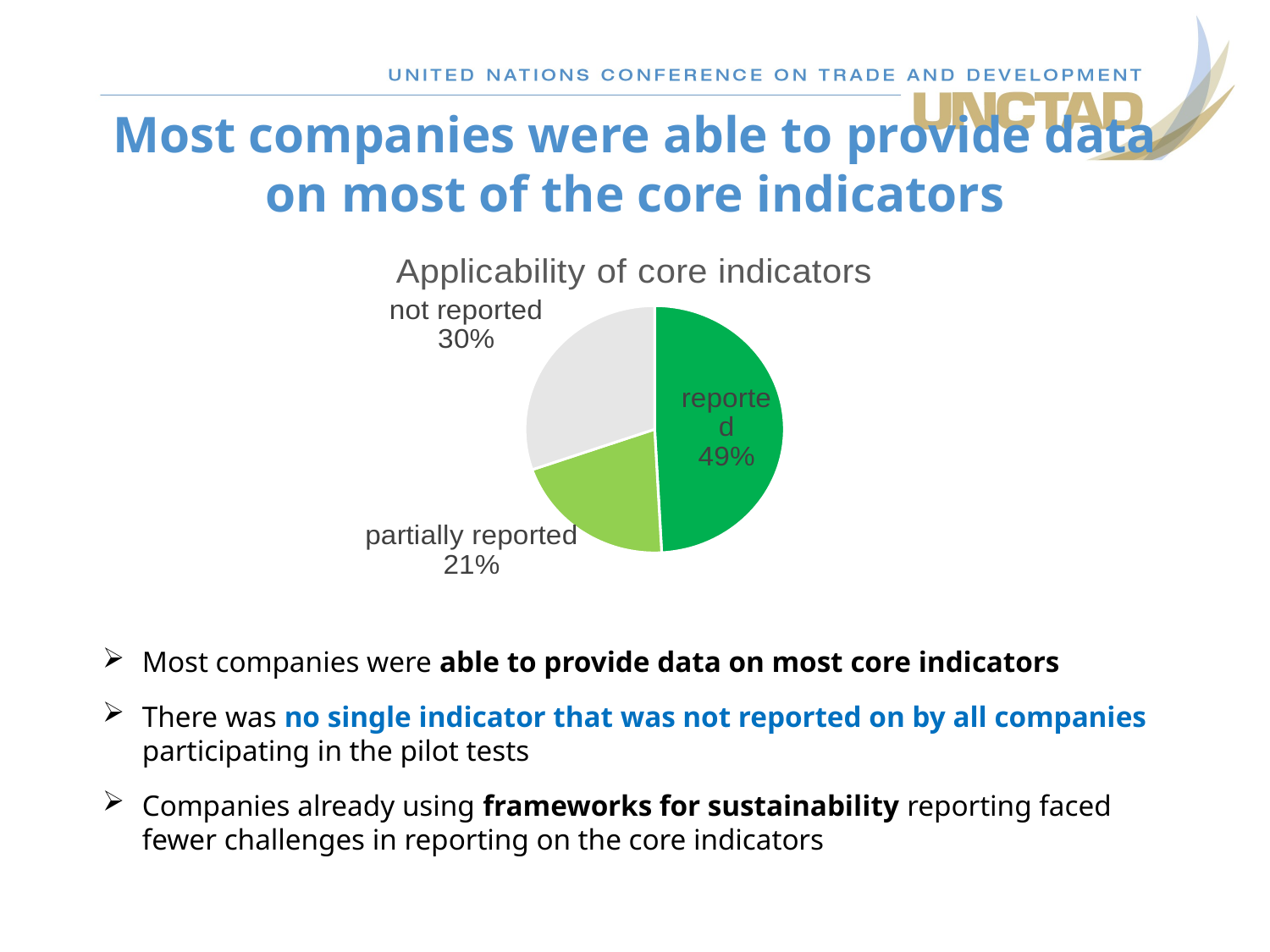
Which slice of the pie chart is the largest? reported What is the title of the pie chart? Applicability of core indicators What share of the pie is labelled "not reported"? 30% What is the combined share of the "reported" and "partially reported" slices? 70% What share of the pie is labelled "partially reported"? 21% Which is larger, the "not reported" slice or the "partially reported" slice? not reported What colour is the "reported" slice of the pie chart? green What share of the pie is labelled "reported"? 49% Which slice of the pie chart is the smallest? partially reported What kind of chart is shown on the slide? pie chart What is the difference in percentage points between the "reported" and "not reported" slices? 19 How many slices does the pie chart have? 3